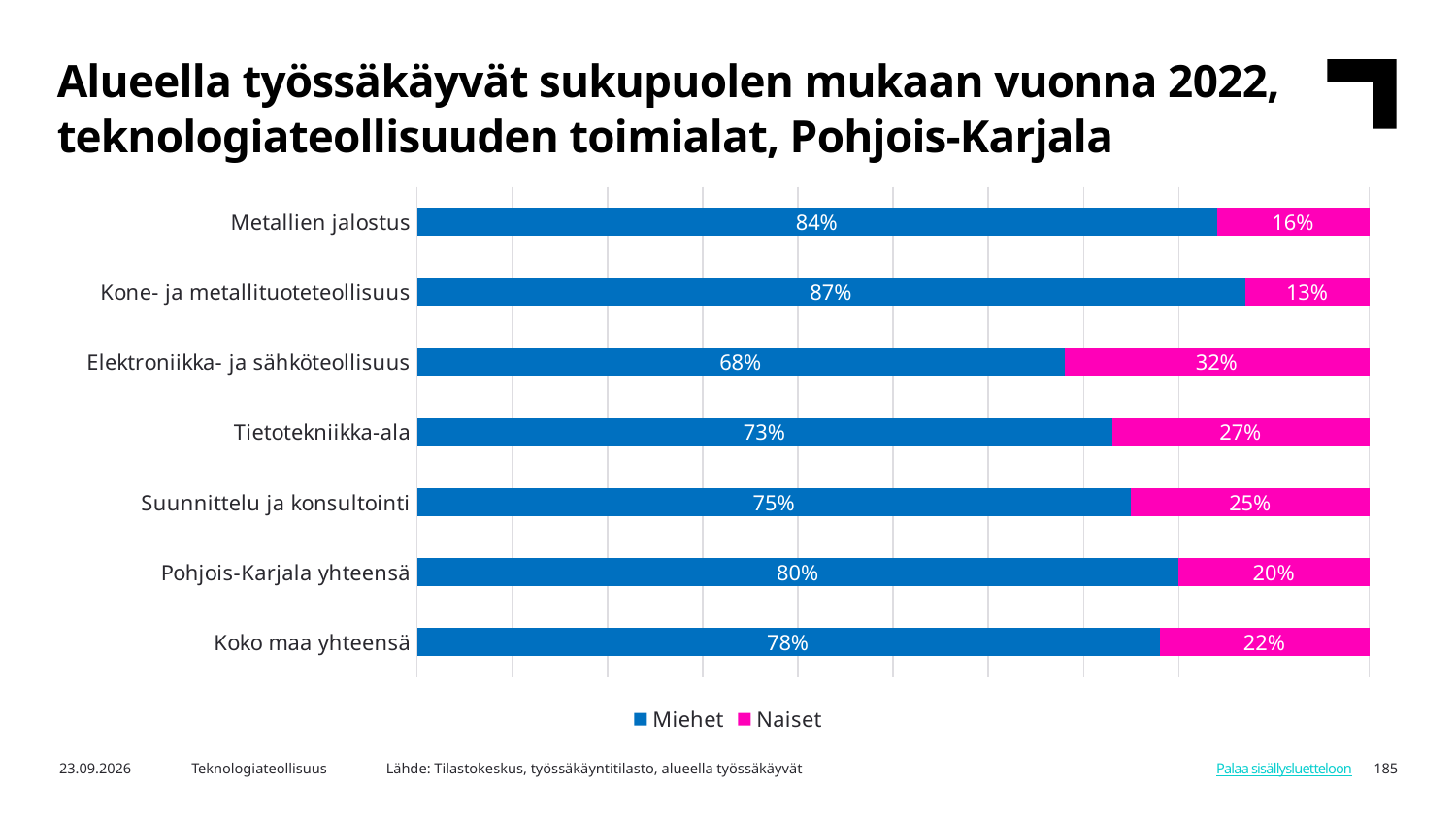
Which is larger: the Naiset share for Tietotekniikka-ala or for Suunnittelu ja konsultointi? Tietotekniikka-ala What is the total of the stacked bar for Tietotekniikka-ala? 100% Which colour represents Naiset in the chart? Magenta (pink) What is the Miehet share for Metallien jalostus? 84% How many categories are shown on the chart? 7 What is the Naiset share for Koko maa yhteensä? 22% Which category has the lowest Naiset share? Kone- ja metallituoteteollisuus How many series does the legend list? 2 Which category has the highest Miehet share? Kone- ja metallituoteteollisuus What kind of chart is shown on the slide? Stacked bar chart What is the difference between the Miehet share for Pohjois-Karjala yhteensä and Koko maa yhteensä? 2 percentage points What is the Naiset share for Elektroniikka- ja sähköteollisuus? 32%